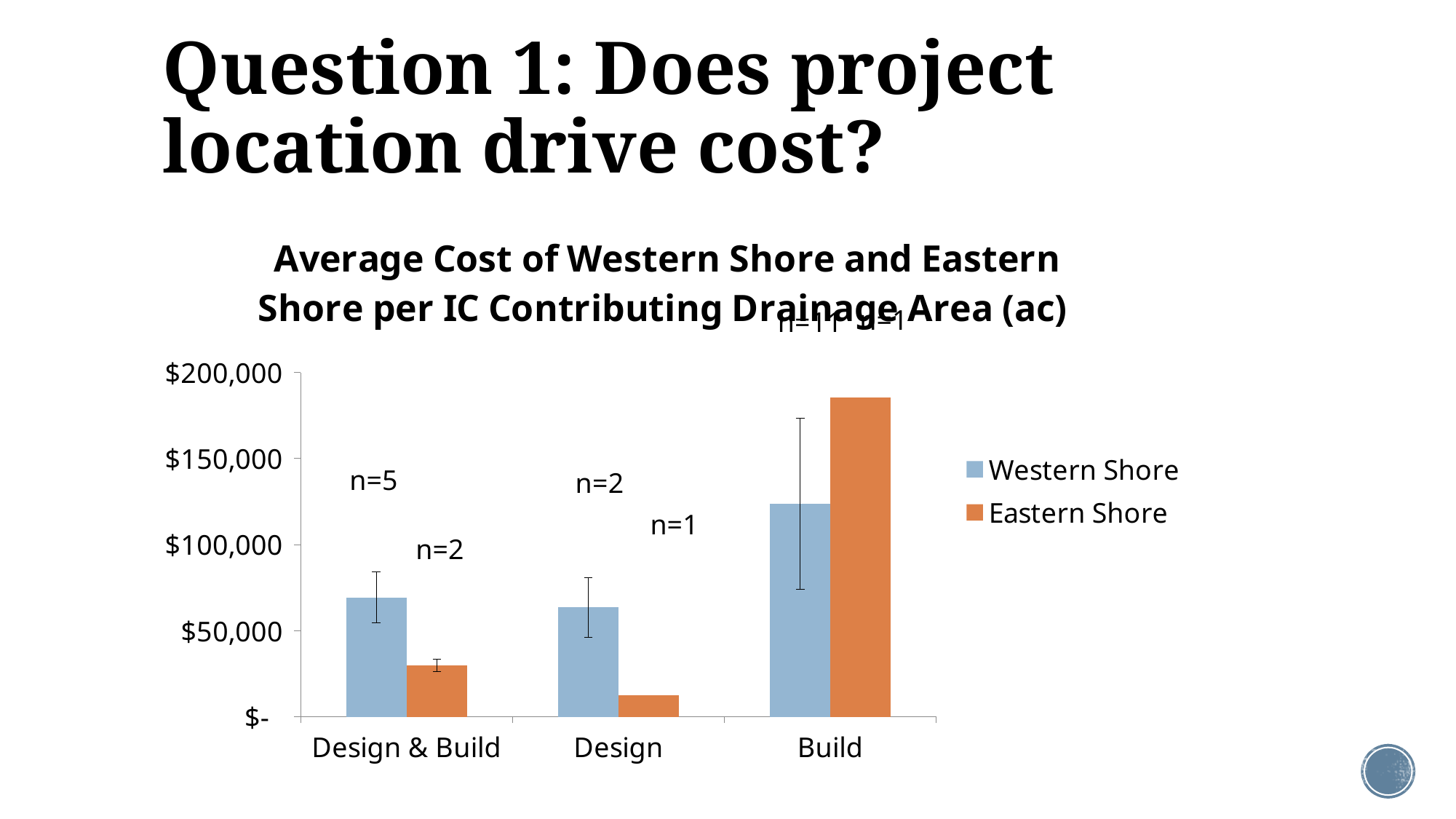
Which colour represents Eastern Shore in the legend? orange For Build, which is larger: Western Shore or Eastern Shore? Eastern Shore Which category has the highest Eastern Shore value? Build How many series does the legend list? 2 What kind of chart is shown on the slide? bar chart Which category has the lowest Eastern Shore value? Design For Design & Build, which is larger: Western Shore or Eastern Shore? Western Shore Is the Eastern Shore value for Design & Build greater or less than $50,000? less Which category has the highest Western Shore value? Build How many categories are shown on the x axis? 3 Is the Eastern Shore value for Build greater or less than $150,000? greater Is the Western Shore value for Build greater or less than $100,000? greater